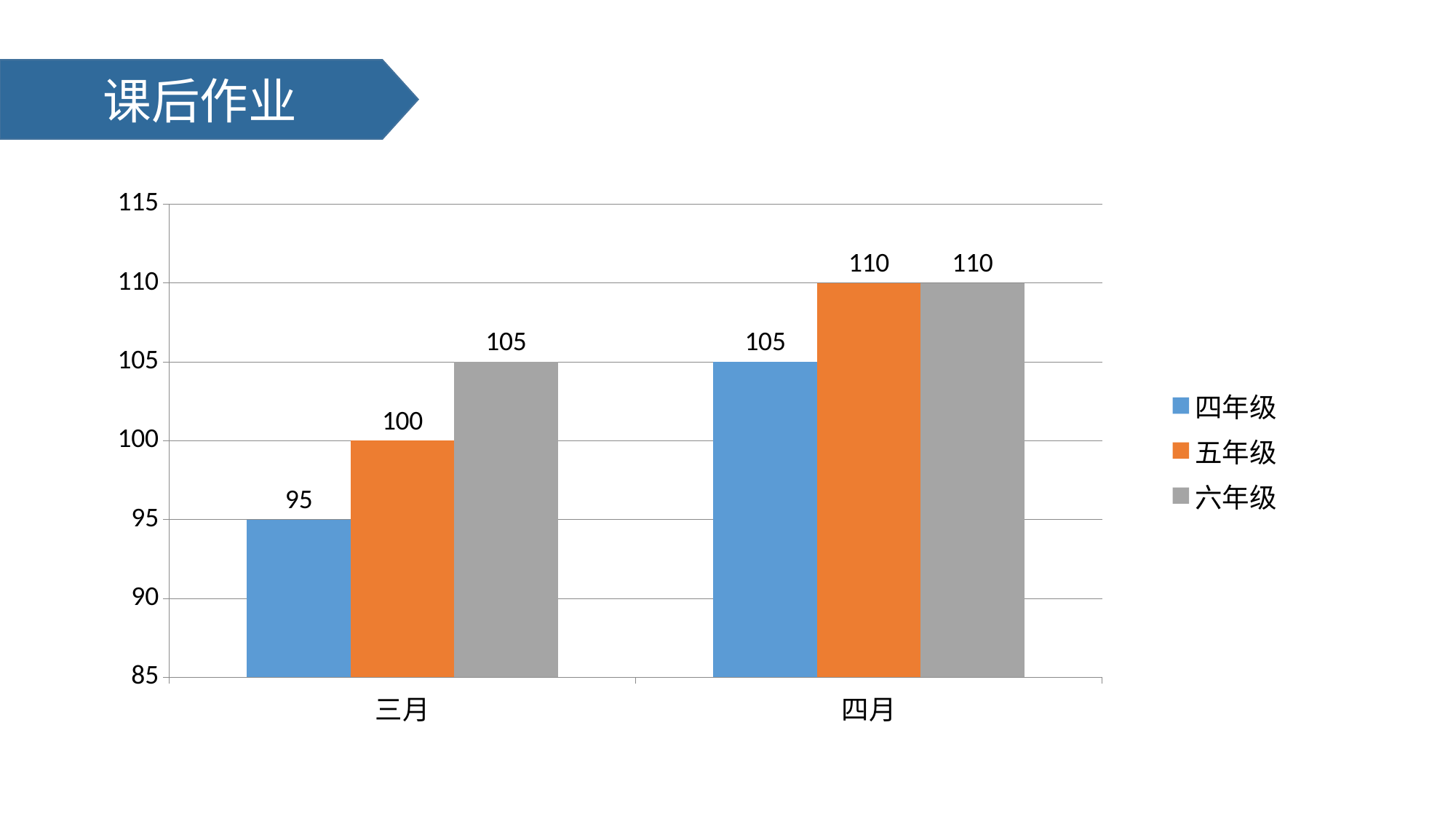
What is the value for 六年级 in 三月? 105 How many series does the legend list? 3 How many categories are shown on the x axis? 2 What is the value for 四年级 in 三月? 95 Does the 五年级 value rise or fall from 三月 to 四月? Rise What is the difference between 六年级 and 五年级 in 三月? 5 What is the value for 五年级 in 四月? 110 Which is larger, the 四年级 value in 四月 or the 五年级 value in 三月? 四年级 in 四月 Which series has the lowest value in 三月? 四年级 What kind of chart is shown on the slide? Bar chart Which series has the highest value in 三月? 六年级 What is the difference between the 四年级 values for 四月 and 三月? 10